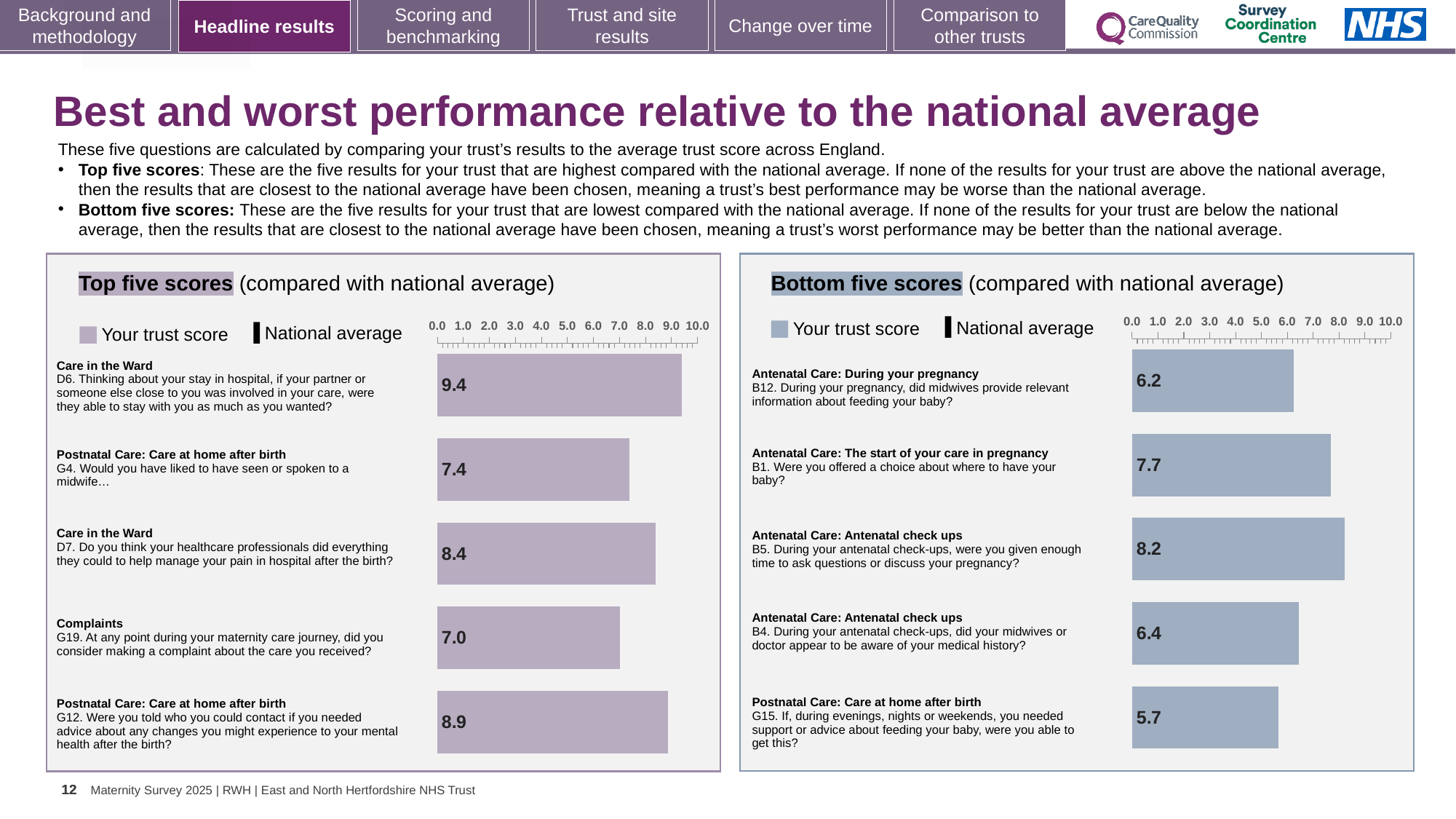
What kind of chart is the Top five scores chart? Bar chart In the Top five scores chart, what is the trust score for D6 (partner able to stay with you as much as you wanted)? 9.4 In the Bottom five scores chart, which question has the highest trust score? B5 How many questions are shown in the Bottom five scores chart? 5 In the Bottom five scores chart, what is the trust score for G15 (support or advice about feeding your baby during evenings, nights or weekends)? 5.7 In the Bottom five scores chart, what is the trust score for B1 (offered a choice about where to have your baby)? 7.7 In the Top five scores chart, which question has the highest trust score? D6 In the Top five scores chart, what is the trust score for G19 (consider making a complaint)? 7.0 In the Top five scores chart, which has the larger trust score, D7 or G12? G12 In the Bottom five scores chart, which question has the lowest trust score? G15 In the Bottom five scores chart, what is the difference between the trust scores for B5 and B12? 2.0 In the Top five scores chart, what is the difference between the trust scores for D6 and G4? 2.0